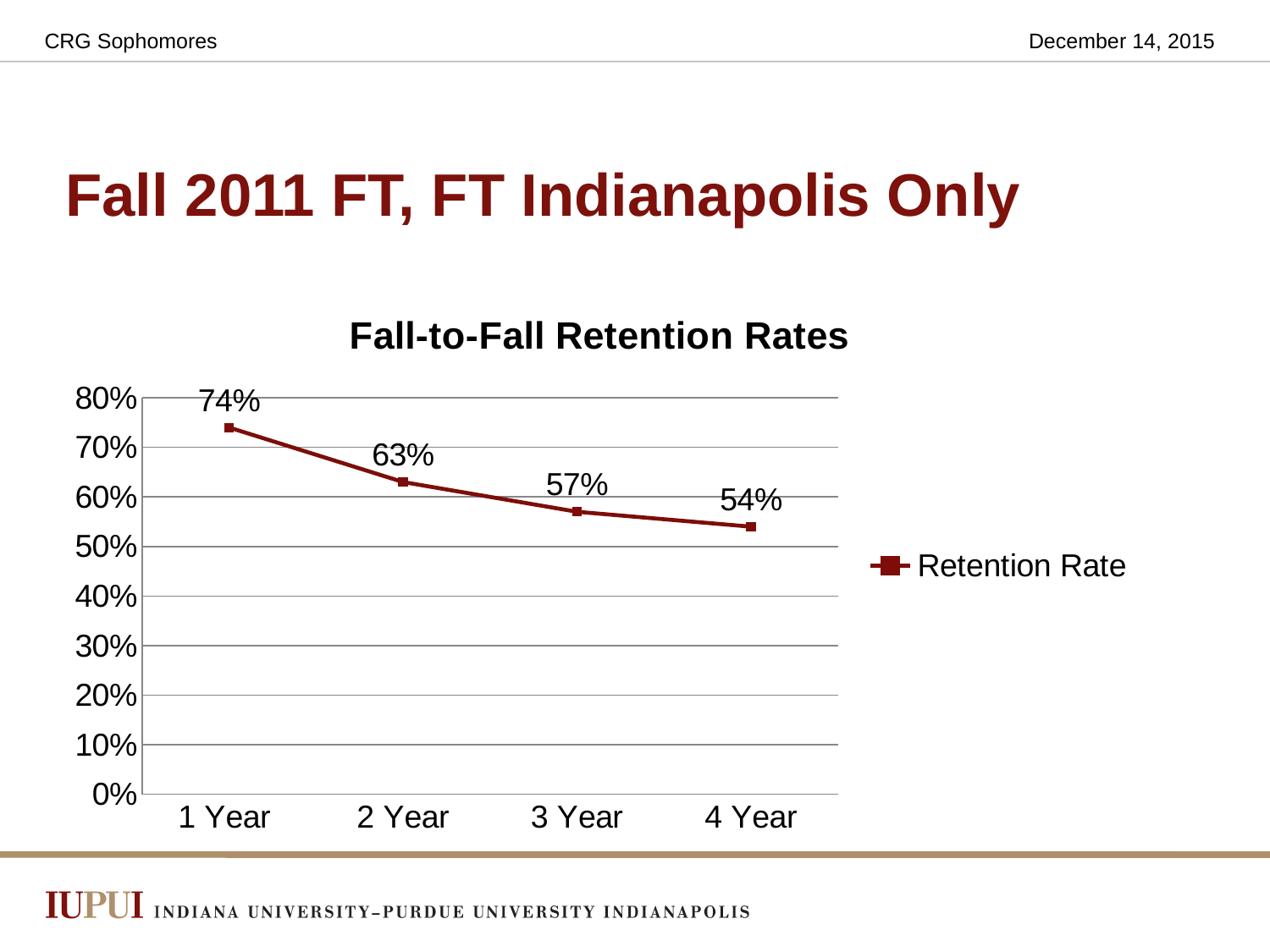
Do the retention rates rise or fall from 1 Year to 4 Year? Fall What kind of chart is shown? Line chart What is the retention rate at 2 Year? 63% How many data points are plotted on the chart? 4 What is the retention rate at 4 Year? 54% What is the difference between the retention rate at 1 Year and at 4 Year? 20% What is the retention rate at 3 Year? 57% What is the retention rate at 1 Year? 74% Which year has the highest retention rate? 1 Year How many series does the legend list? 1 Which is larger, the retention rate at 2 Year or at 3 Year? 2 Year Which year has the lowest retention rate? 4 Year